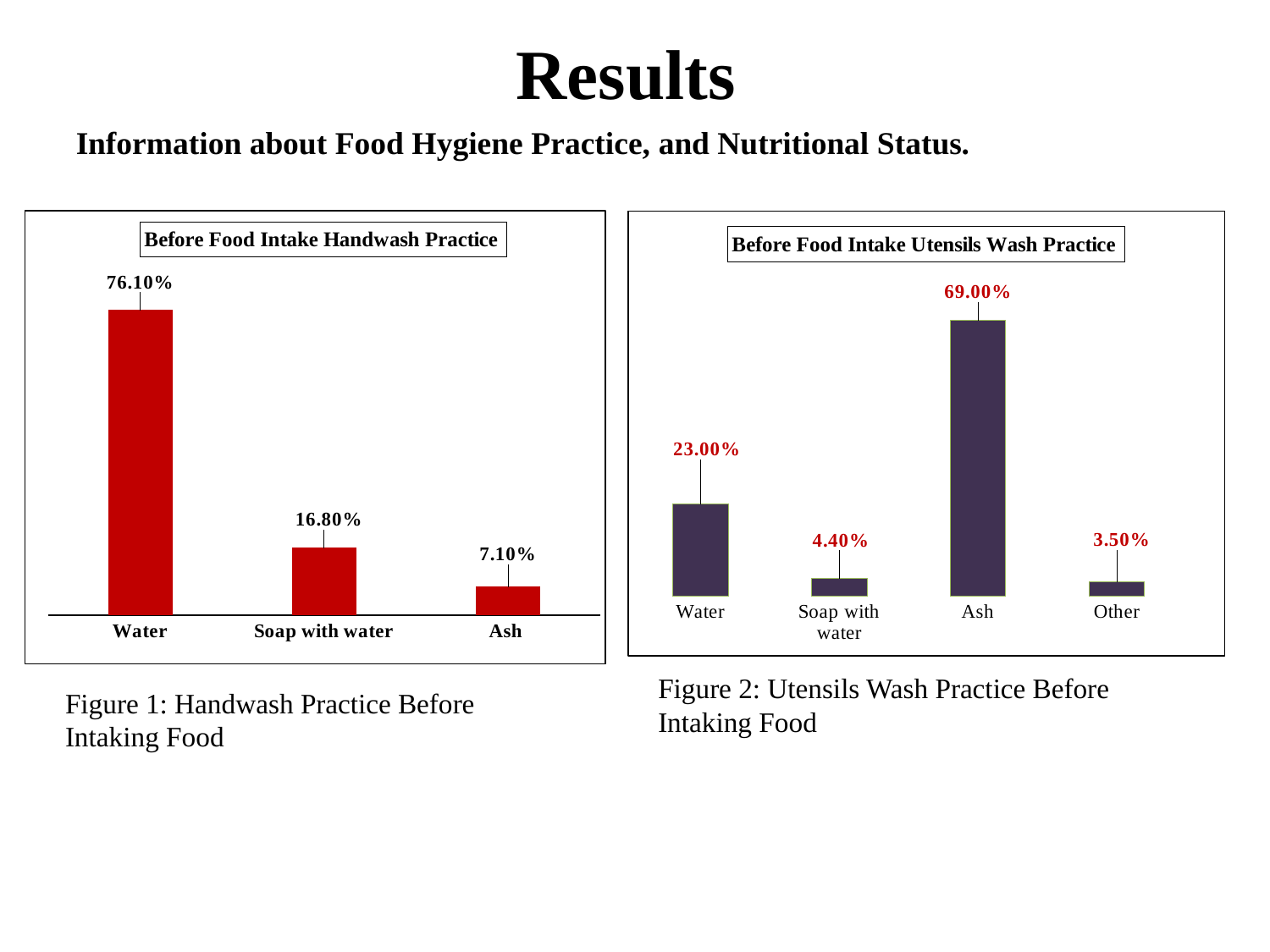
What kind of chart is the 'Before Food Intake Utensils Wash Practice' chart? Bar chart In the 'Before Food Intake Utensils Wash Practice' chart, what is the value for Ash? 69.00% In the 'Before Food Intake Utensils Wash Practice' chart, what is the difference between the values for Ash and Water? 46.00% In the 'Before Food Intake Handwash Practice' chart, what is the difference between the values for Water and Soap with water? 59.30% In the 'Before Food Intake Handwash Practice' chart, what is the value for Soap with water? 16.80% In the 'Before Food Intake Utensils Wash Practice' chart, how many categories are shown? 4 In the 'Before Food Intake Handwash Practice' chart, how many categories are shown? 3 In the 'Before Food Intake Utensils Wash Practice' chart, what is the value for Other? 3.50% In the 'Before Food Intake Utensils Wash Practice' chart, which is larger, the value for Water or the value for Soap with water? Water In the 'Before Food Intake Utensils Wash Practice' chart, which category has the highest value? Ash In the 'Before Food Intake Handwash Practice' chart, what is the value for Water? 76.10% In the 'Before Food Intake Handwash Practice' chart, which category has the lowest value? Ash